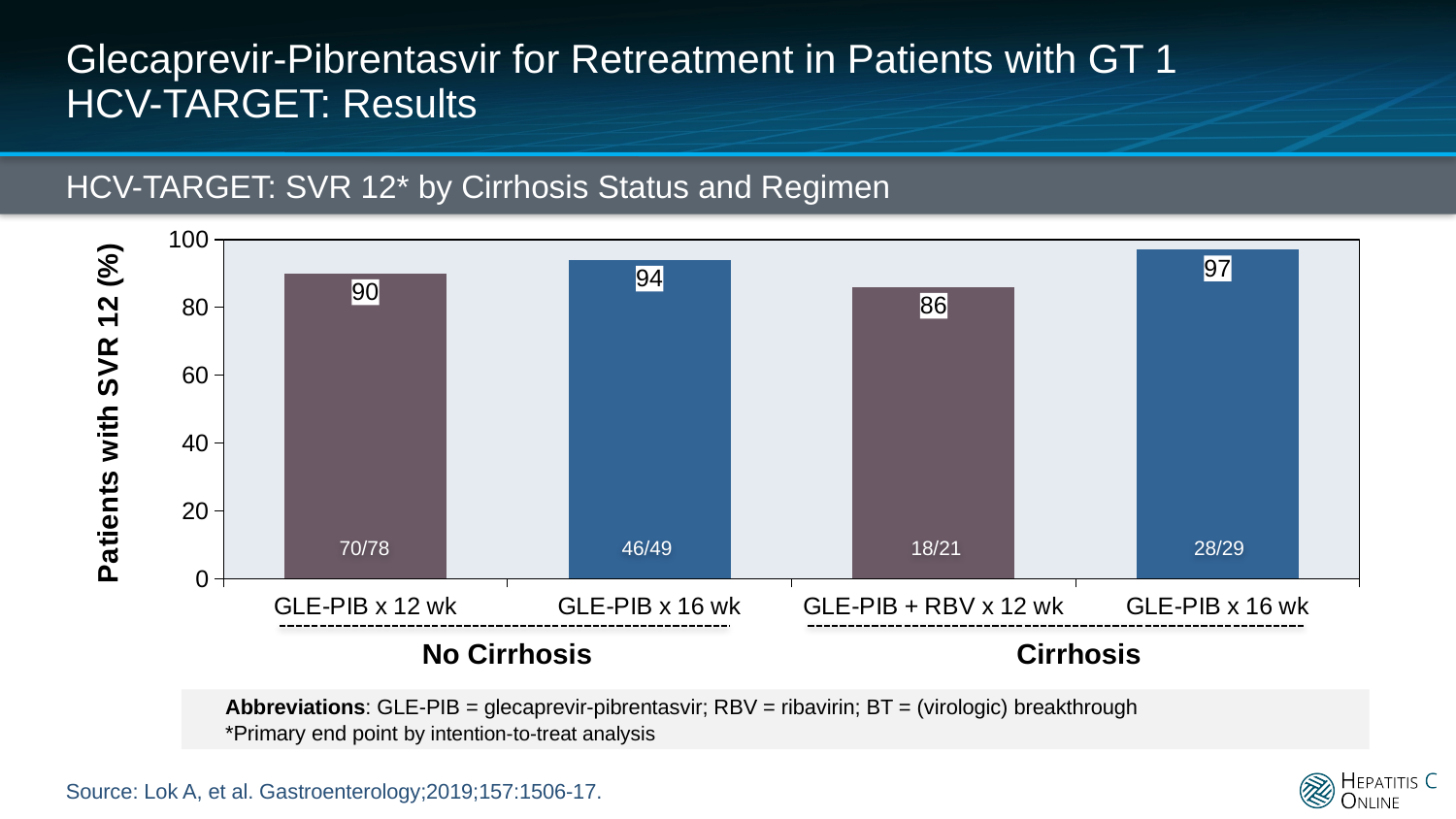
What is the label of the y-axis of the chart? Patients with SVR 12 (%) What kind of chart is shown on the slide? Bar chart What is the SVR 12 rate for GLE-PIB x 16 wk in patients with cirrhosis? 97 What is the difference in SVR 12 rate between GLE-PIB x 16 wk and GLE-PIB + RBV x 12 wk in the cirrhosis group? 11 What is the SVR 12 rate for GLE-PIB + RBV x 12 wk in patients with cirrhosis? 86 How many bars are shown in the chart? 4 Which has a higher SVR 12 rate: GLE-PIB x 12 wk in no cirrhosis or GLE-PIB + RBV x 12 wk in cirrhosis? GLE-PIB x 12 wk in no cirrhosis What is the difference in SVR 12 rate between GLE-PIB x 16 wk and GLE-PIB x 12 wk in the no cirrhosis group? 4 Which bar has the lowest SVR 12 rate? GLE-PIB + RBV x 12 wk (Cirrhosis) What is the SVR 12 rate for GLE-PIB x 12 wk in patients with no cirrhosis? 90 Which bar has the highest SVR 12 rate? GLE-PIB x 16 wk (Cirrhosis) What fraction of patients is shown inside the GLE-PIB x 16 wk bar in the no cirrhosis group? 46/49